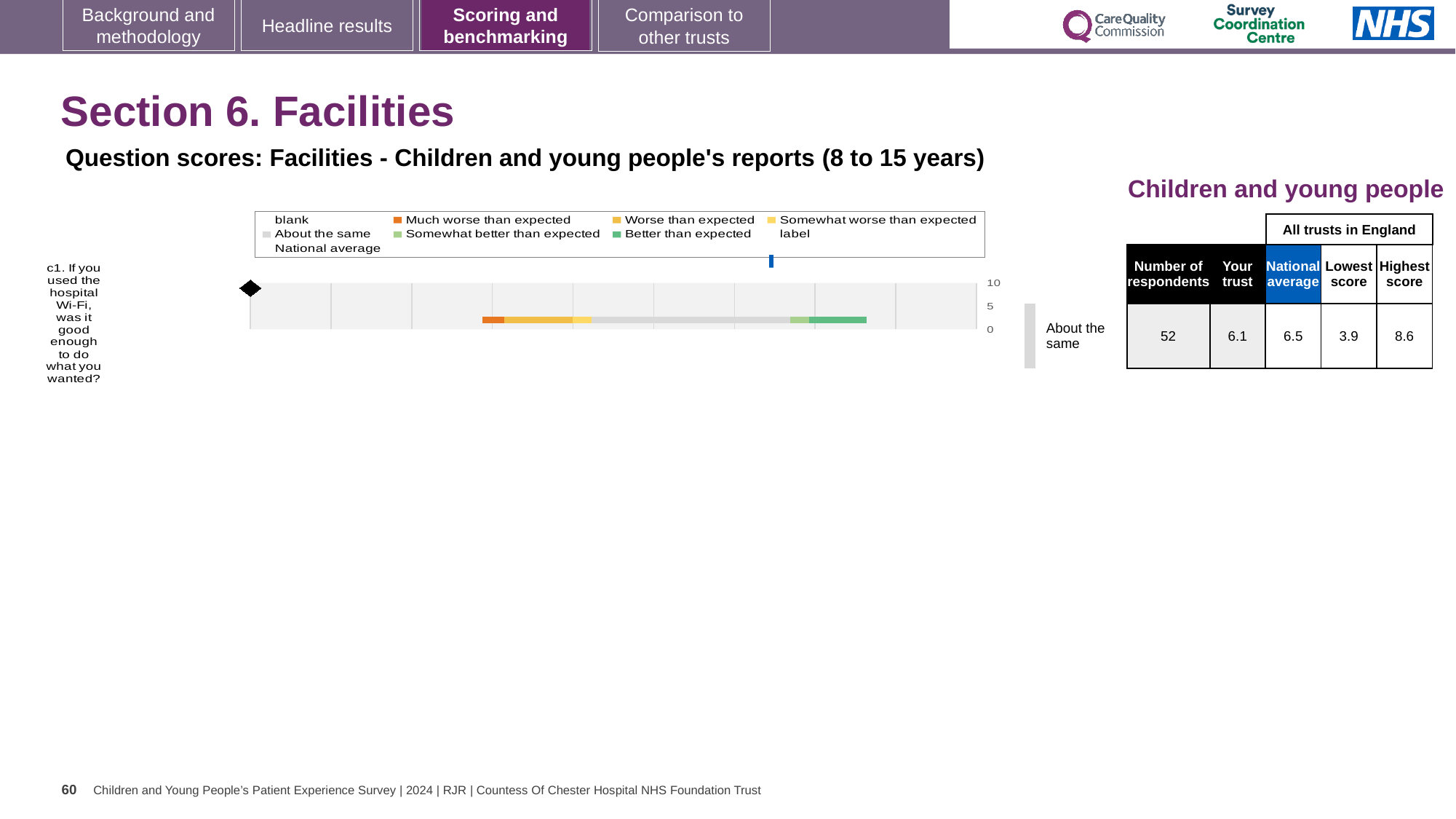
How many survey questions are plotted in the chart? 1 What is the lowest score among all trusts in England for question c1? 3.9 How many respondents answered question c1 about the hospital Wi-Fi? 52 What is the difference between the highest score and the lowest score for question c1? 4.7 What colour does the legend use for 'Better than expected'? green What is the national average score for question c1 about the hospital Wi-Fi? 6.5 What kind of chart is used to show the question score for c1 (hospital Wi-Fi)? bar chart What is the 'Your trust' score for question c1 about the hospital Wi-Fi? 6.1 Is the national average marker for question c1 greater or less than 5 on the chart axis? greater What is the highest score among all trusts in England for question c1? 8.6 Which is larger for question c1: the 'Your trust' score or the national average? National average What colour does the legend use for 'Much worse than expected'? orange